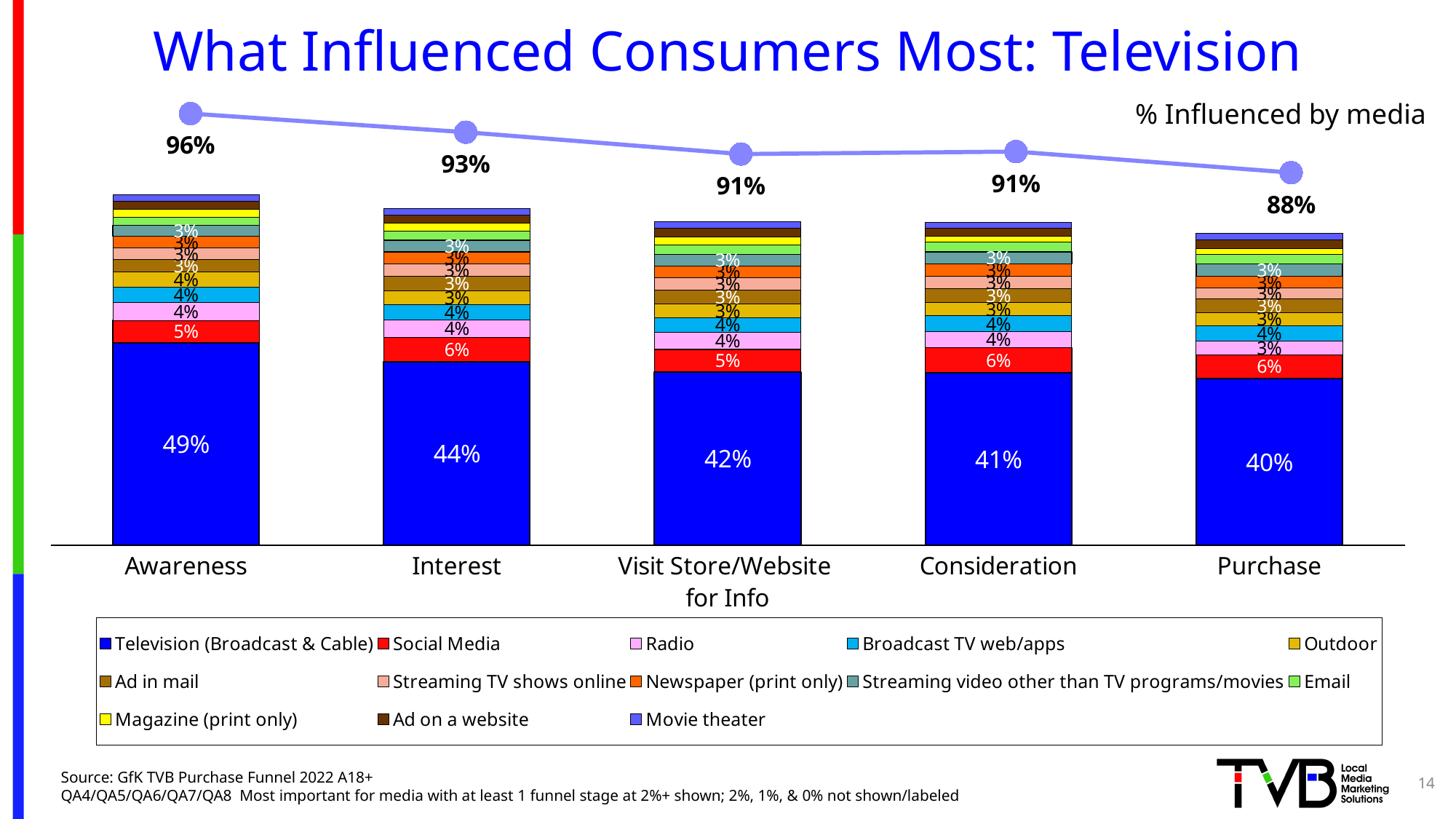
How many series does the legend list? 13 Does the % Influenced by media line rise or fall from Awareness to Purchase? fall How many funnel stages are shown on the x axis? 5 What is the % Influenced by media value at the Interest stage? 93% Which is larger, the Television (Broadcast & Cable) value for Interest or for Consideration? Interest What is the difference between the Television (Broadcast & Cable) values for Awareness and Purchase? 9% What is the Social Media value for the Consideration stage? 6% Which funnel stage has the highest Television (Broadcast & Cable) value? Awareness What is the Television (Broadcast & Cable) value for the Awareness stage? 49% What is the Television (Broadcast & Cable) value for the Purchase stage? 40% What is the difference between the % Influenced by media values for Awareness and Purchase? 8% Which funnel stage has the lowest % Influenced by media value? Purchase